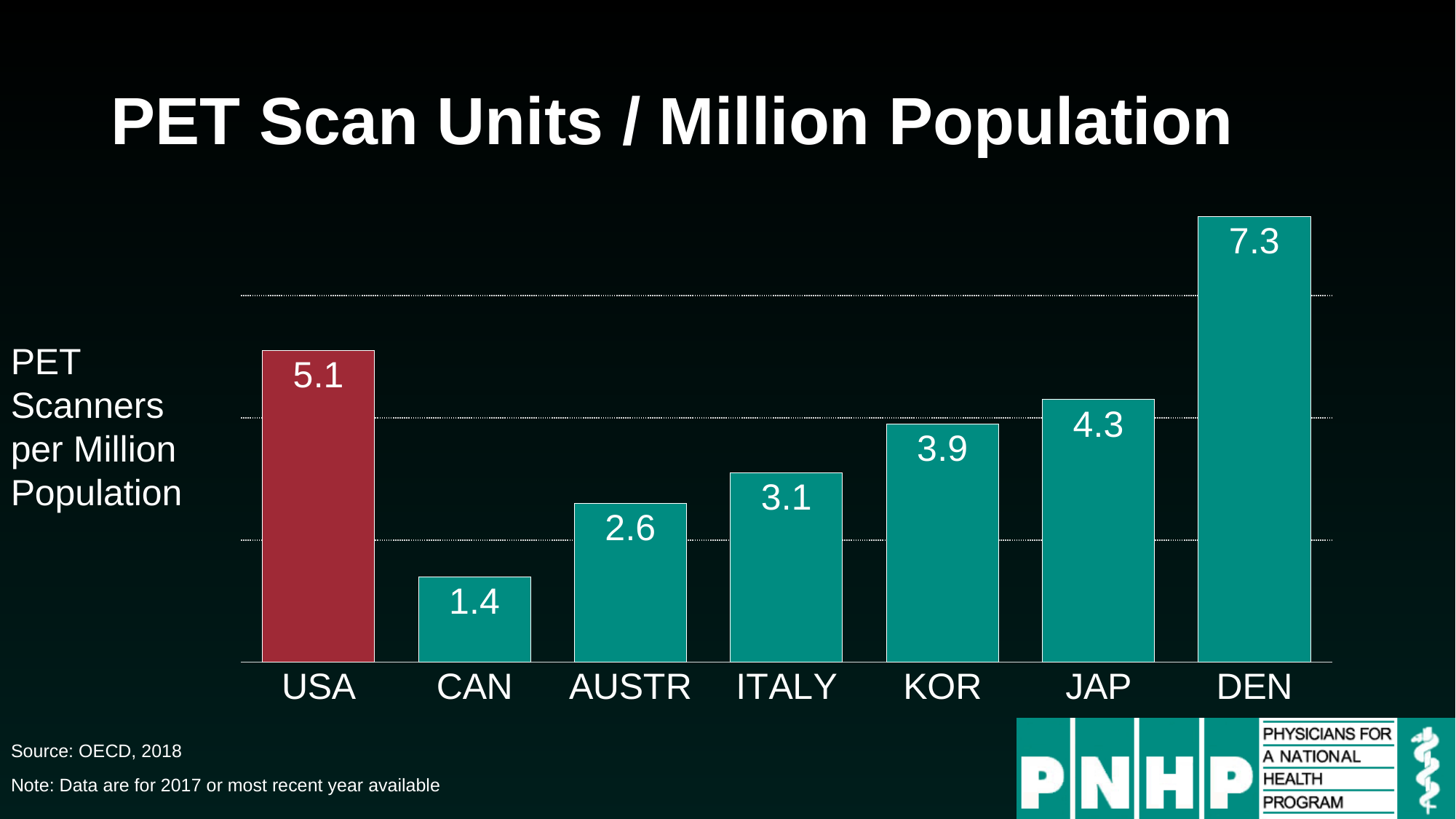
What is the difference between the values for DEN and USA? 2.2 How many countries are shown in the chart? 7 Which country has the highest value? DEN What is the value for CAN? 1.4 What is the difference between the values for JAP and ITALY? 1.2 Which country has the lowest value? CAN What is the value for USA? 5.1 Which is larger, the value for AUSTR or the value for ITALY? ITALY What is the title of the chart? PET Scan Units / Million Population Which bar is shown in a different colour (red) from the others? USA What is the value for KOR? 3.9 What kind of chart is shown on the slide? Bar chart